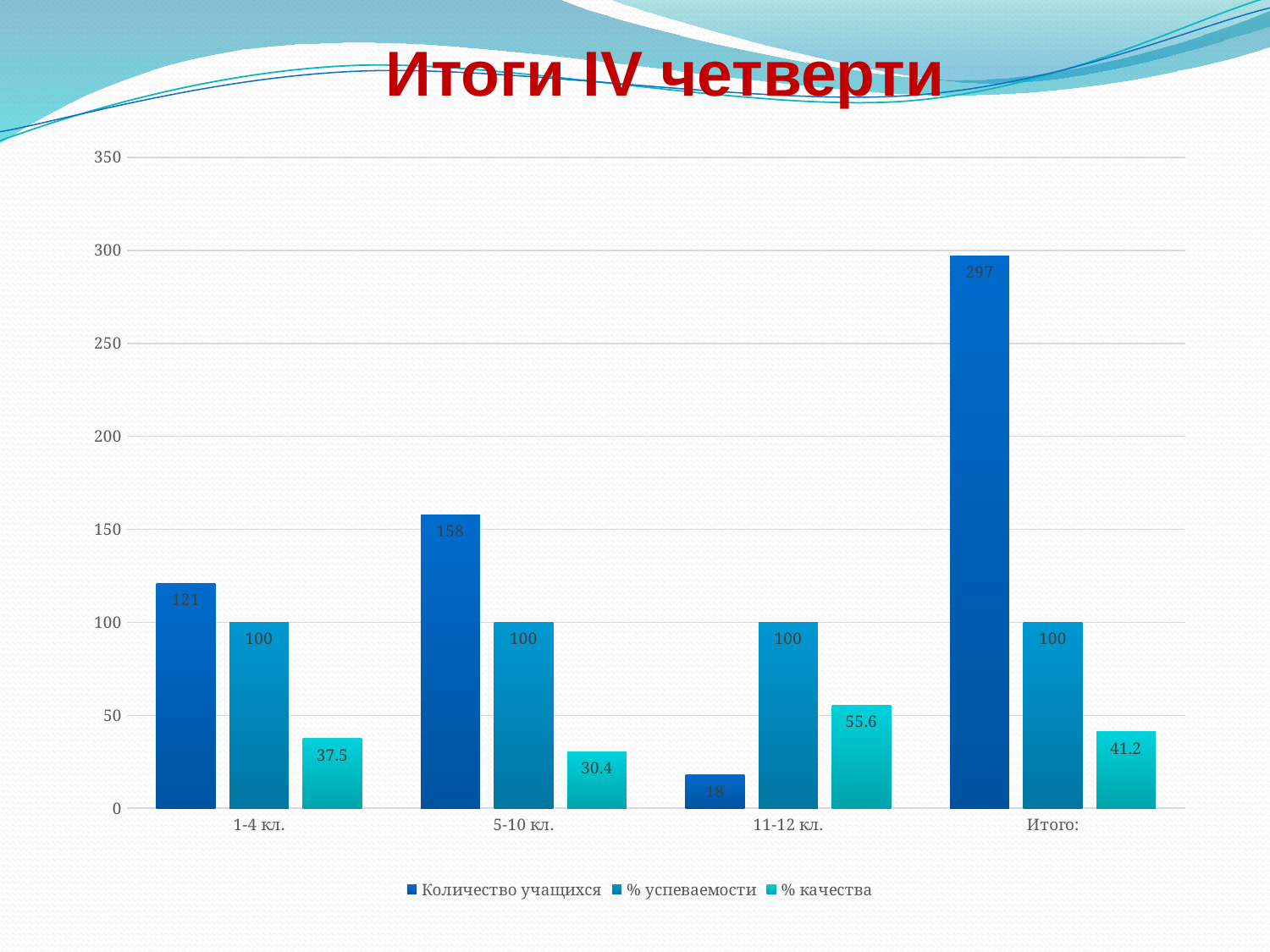
What is the title of the slide? Итоги IV четверти What kind of chart is shown on the slide? Bar chart Which is larger: % качества for 1-4 кл. or for 5-10 кл.? 1-4 кл. What is the value of Количество учащихся for 5-10 кл.? 158 How many series does the legend list? 3 What is the % качества value for 11-12 кл.? 55.6 Which category has the lowest Количество учащихся? 11-12 кл. What is the Количество учащихся value for Итого:? 297 Is the Количество учащихся value for Итого: greater or less than 250? greater Which category has the highest % качества? 11-12 кл. How many categories are shown on the x axis? 4 What is the difference between Количество учащихся for 5-10 кл. and 1-4 кл.? 37